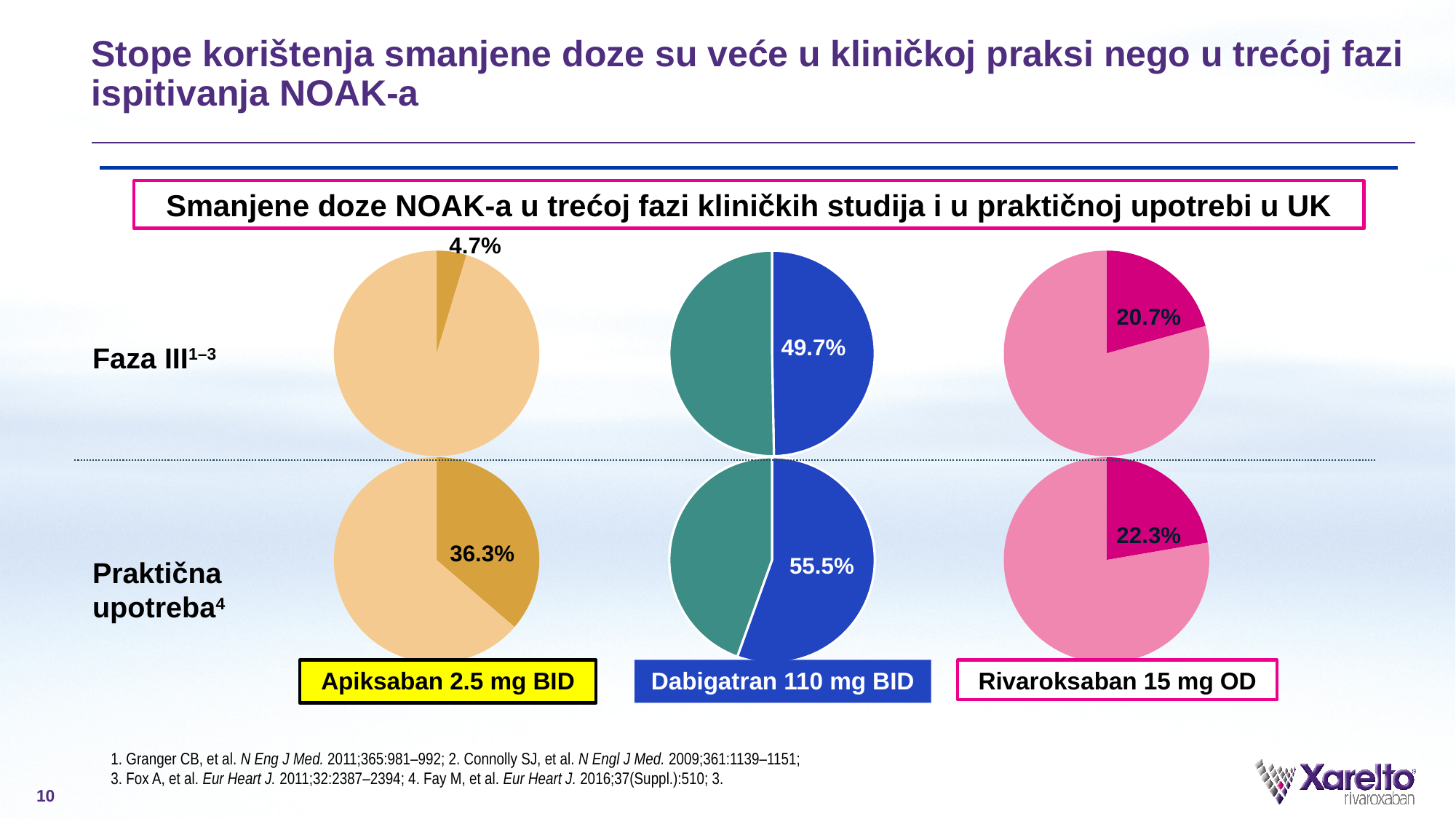
Which drug has the lowest labelled reduced-dose share in the Faza III row? Apiksaban 2.5 mg BID In the Faza III pie chart for Apiksaban 2.5 mg BID, what share is shown for the reduced dose? 4.7% In the Faza III pie chart for Rivaroksaban 15 mg OD, what percentage is labelled? 20.7% In the Praktična upotreba pie chart for Dabigatran 110 mg BID, what percentage is labelled? 55.5% What is the difference between the Praktična upotreba and Faza III percentages for Dabigatran 110 mg BID? 5.8% What is the difference between the Praktična upotreba and Faza III reduced-dose shares for Apiksaban 2.5 mg BID? 31.6% What type of charts are used on this slide? pie charts Is the Faza III reduced-dose share for Rivaroksaban 15 mg OD larger or smaller than its Praktična upotreba share? smaller In the Praktična upotreba pie chart for Apiksaban 2.5 mg BID, what share is shown for the reduced dose? 36.3% Which drug has the highest labelled reduced-dose share in the Praktična upotreba row? Dabigatran 110 mg BID In the Faza III pie chart for Dabigatran 110 mg BID, what percentage is labelled? 49.7% In the Praktična upotreba pie chart for Rivaroksaban 15 mg OD, what percentage is labelled? 22.3%